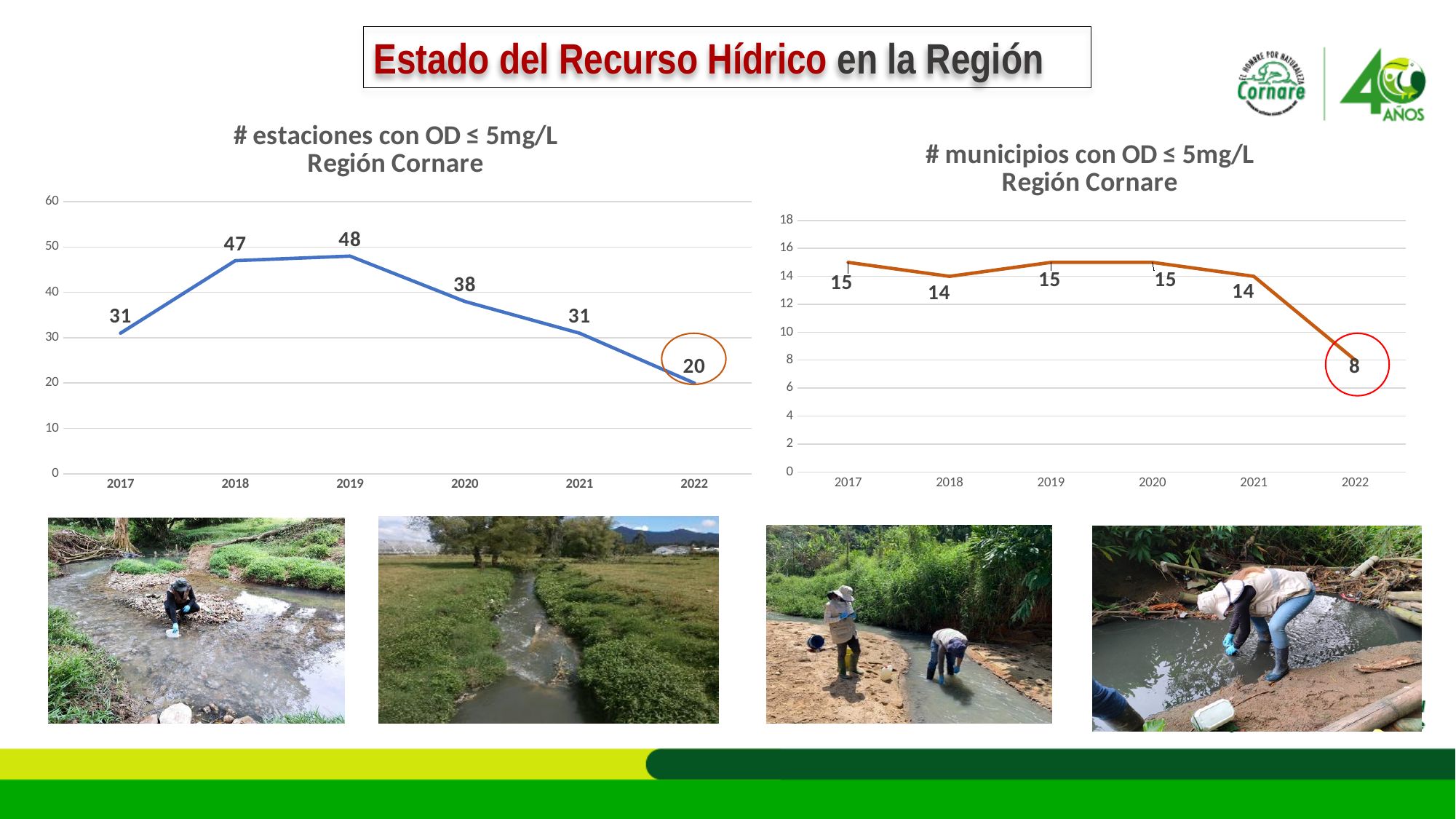
In the '# municipios con OD ≤ 5mg/L Región Cornare' chart, what is the value for 2018? 14 In the '# estaciones con OD ≤ 5mg/L Región Cornare' chart, which year has the lowest value? 2022 In the '# estaciones con OD ≤ 5mg/L Región Cornare' chart, what is the value for 2022? 20 In the '# municipios con OD ≤ 5mg/L Región Cornare' chart, which year has the lowest value? 2022 In the '# estaciones con OD ≤ 5mg/L Región Cornare' chart, which year has the highest value? 2019 What kind of chart is the '# municipios con OD ≤ 5mg/L Región Cornare' chart? line chart In the '# municipios con OD ≤ 5mg/L Región Cornare' chart, what is the value for 2022? 8 In the '# estaciones con OD ≤ 5mg/L Región Cornare' chart, what is the difference between the 2019 value and the 2022 value? 28 In the '# estaciones con OD ≤ 5mg/L Región Cornare' chart, how many years are plotted? 6 In the '# municipios con OD ≤ 5mg/L Región Cornare' chart, what is the difference between the 2021 value and the 2022 value? 6 In the '# estaciones con OD ≤ 5mg/L Región Cornare' chart, do the values rise or fall from 2019 to 2022? fall In the '# estaciones con OD ≤ 5mg/L Región Cornare' chart, what is the value for 2019? 48